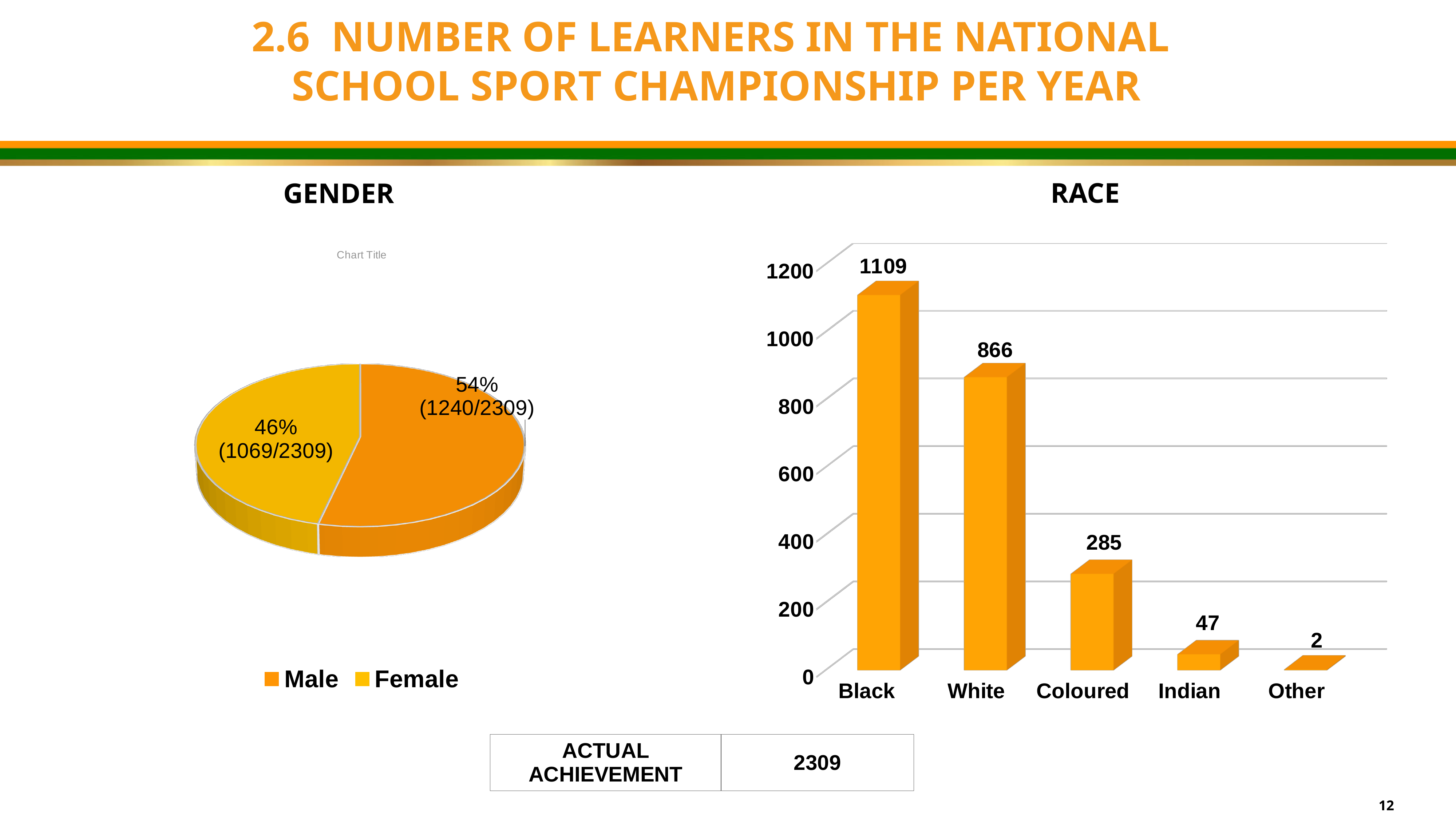
In the RACE bar chart, what is the difference between the values for Black and White? 243 What kind of chart is the GENDER chart? Pie chart How many categories are shown in the RACE bar chart? 5 In the RACE bar chart, what is the value for Black? 1109 In the GENDER pie chart, which slice is larger, Male or Female? Male In the RACE bar chart, which category has the highest value? Black What kind of chart is the RACE chart? Bar chart In the GENDER pie chart, what share of learners is Male? 54% In the GENDER pie chart, what share of learners is Female? 46% How many entries does the legend of the GENDER pie chart list? 2 In the RACE bar chart, which category has the lowest value? Other In the RACE bar chart, what is the value for Coloured? 285